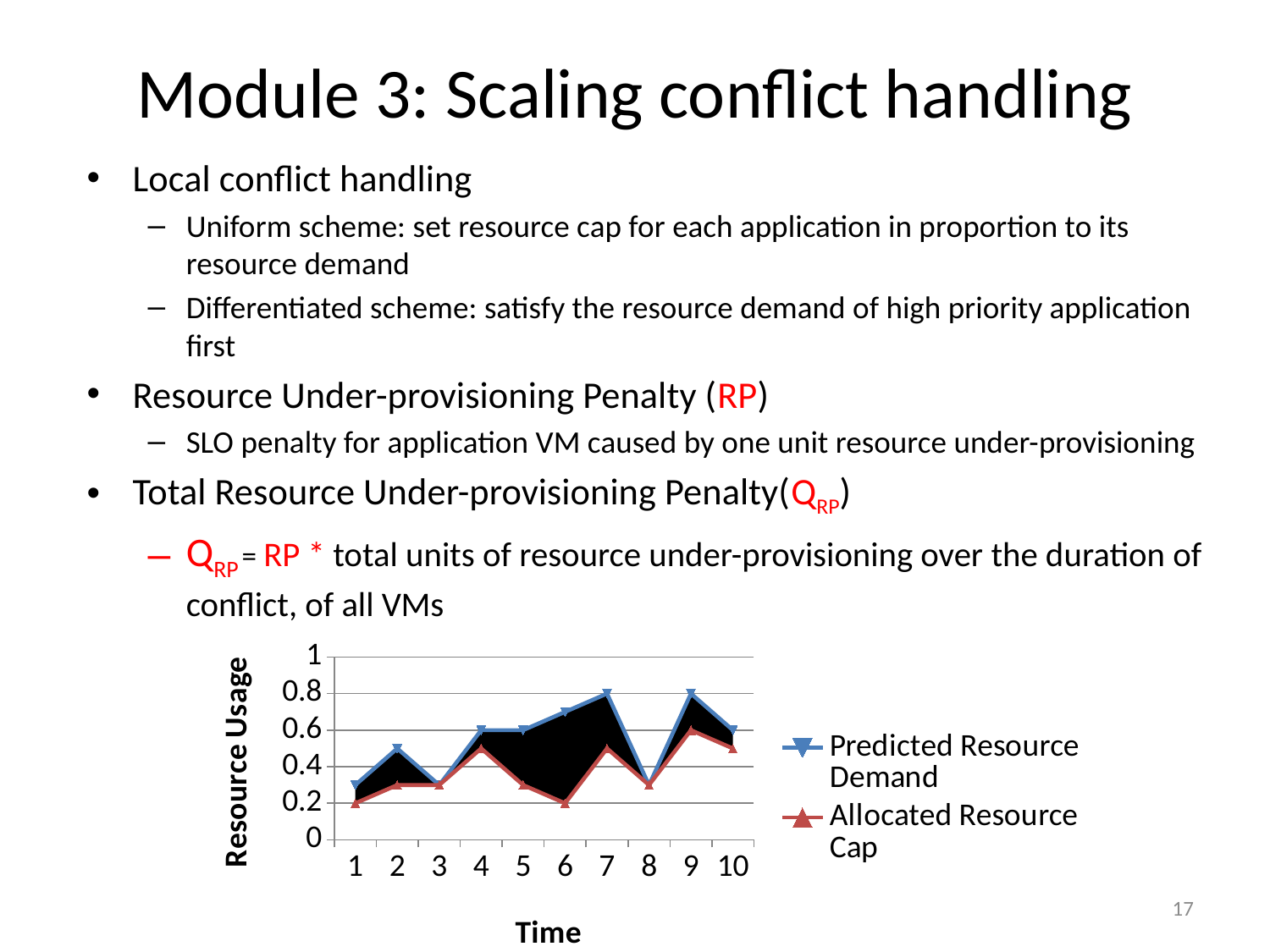
What kind of chart is shown on the slide? line chart Is the Allocated Resource Cap at time 6 greater or less than 0.4? less What is the label of the y axis? Resource Usage Is the Predicted Resource Demand at time 9 greater or less than 0.6? greater What are the two series named in the legend? Predicted Resource Demand; Allocated Resource Cap What is the Allocated Resource Cap at time 1? 0.2 Does the Predicted Resource Demand rise or fall from time 4 to time 7? rise At which time is the Allocated Resource Cap highest? 9 What is the Predicted Resource Demand at time 7? 0.8 At time 6, which is larger: the Predicted Resource Demand or the Allocated Resource Cap? Predicted Resource Demand How many time points are plotted along the x axis? 10 How many series does the legend list? 2